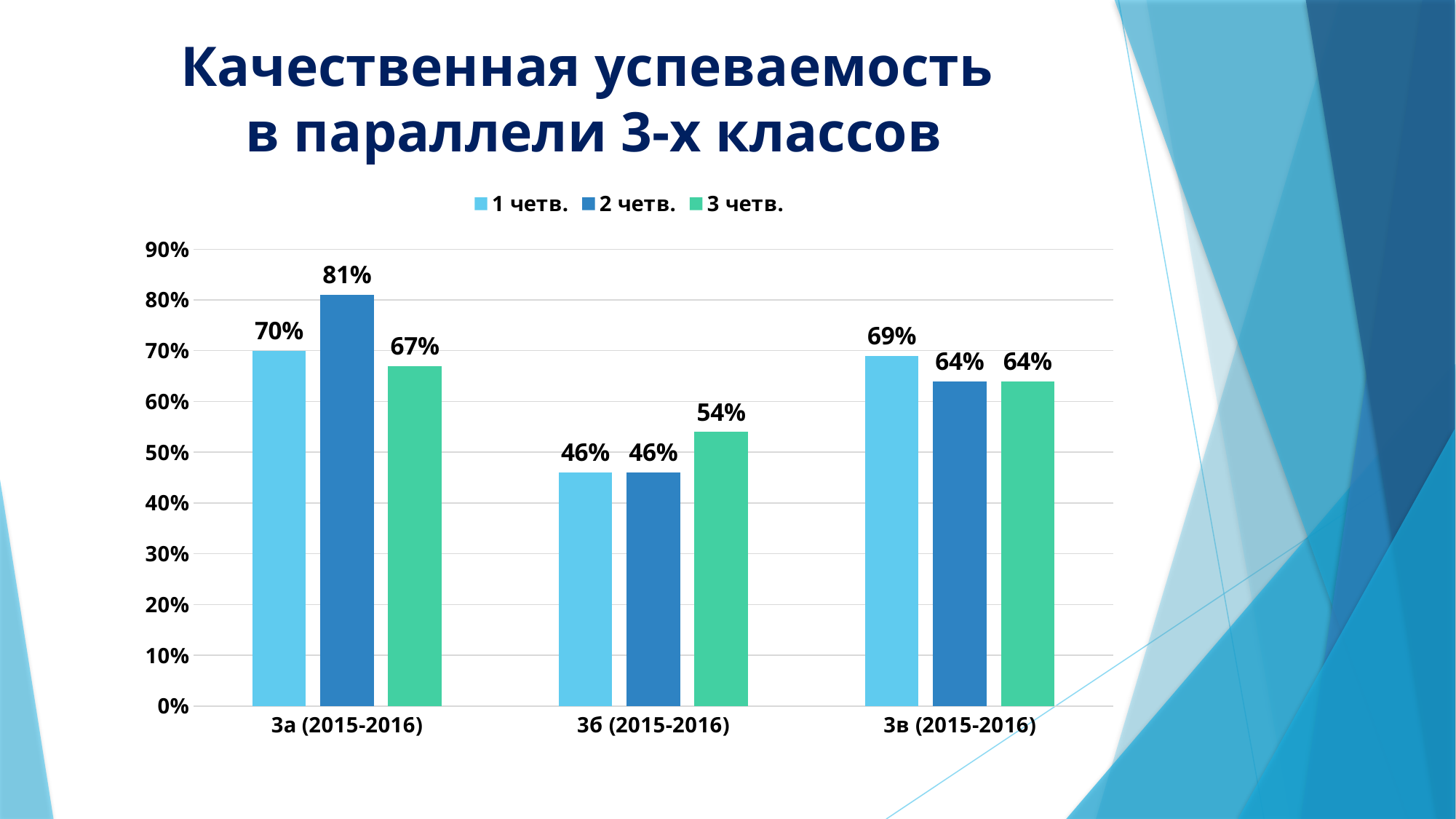
What is the difference between the 2 четв. and 1 четв. values for 3а (2015-2016)? 11% What kind of chart is shown on the slide? bar chart How many categories are shown on the x axis? 3 Is the 3 четв. value for 3а (2015-2016) greater or less than 60%? greater What is the value for 3в (2015-2016) in the 1 четв. series? 69% Which category has the highest value in the 2 четв. series? 3а (2015-2016) Which category has the lowest value in the 1 четв. series? 3б (2015-2016) What is the title of the chart on the slide? Качественная успеваемость в параллели 3-х классов What is the value for 3а (2015-2016) in the 2 четв. series? 81% What is the value for 3б (2015-2016) in the 3 четв. series? 54% Which is larger for 3б (2015-2016): the 3 четв. value or the 1 четв. value? 3 четв. How many series does the legend list? 3